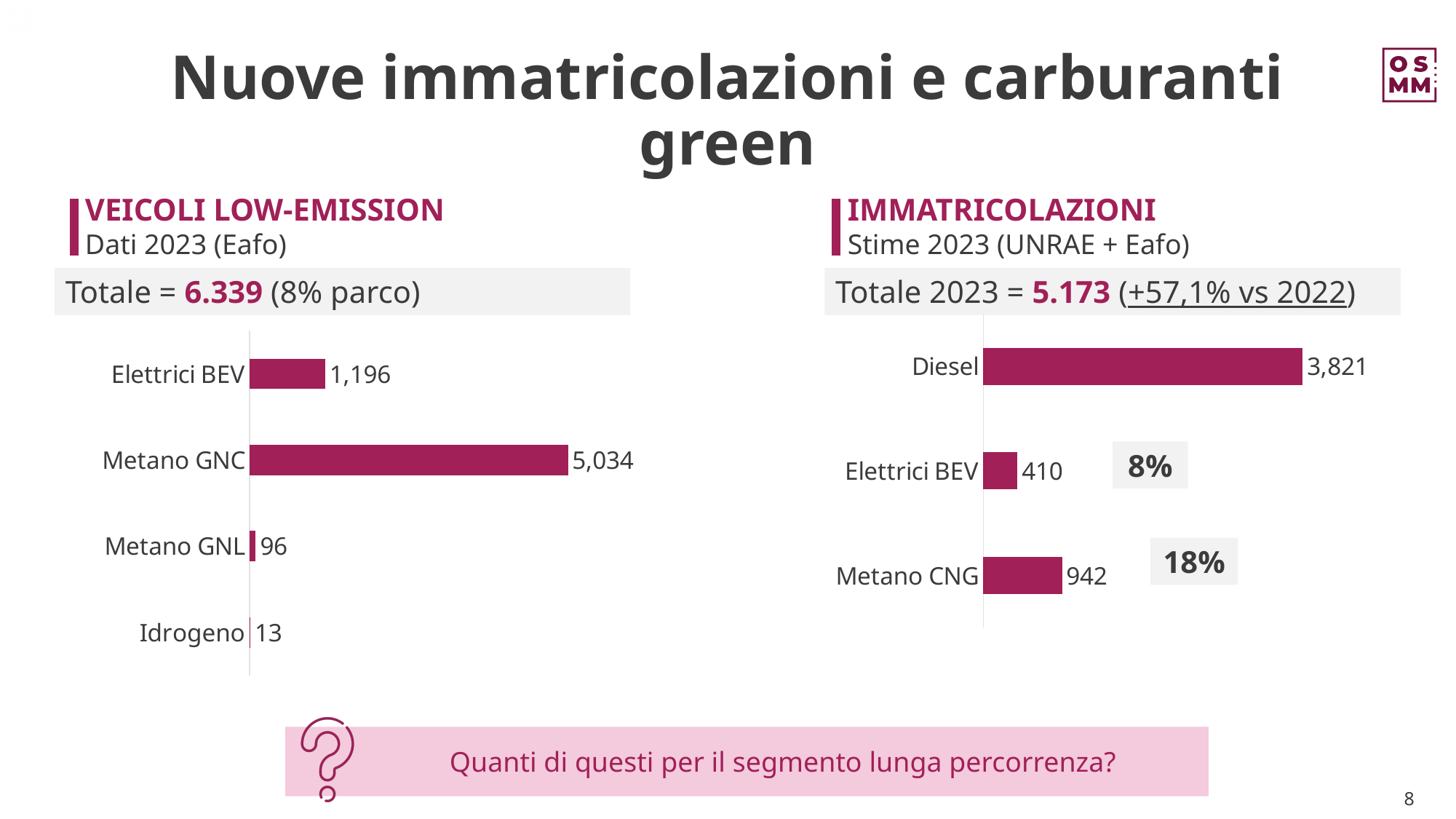
In the VEICOLI LOW-EMISSION chart on the left, which category has the lowest value? Idrogeno In the IMMATRICOLAZIONI chart on the right, what is the value for Metano CNG? 942 What total is stated above the IMMATRICOLAZIONI chart on the right for 2023? 5.173 In the VEICOLI LOW-EMISSION chart on the left, what is the value for Idrogeno? 13 In the IMMATRICOLAZIONI chart on the right, what is the value for Diesel? 3,821 In the IMMATRICOLAZIONI chart on the right, which is larger, Elettrici BEV or Metano CNG? Metano CNG What kind of chart is the IMMATRICOLAZIONI chart on the right? Bar chart In the VEICOLI LOW-EMISSION chart on the left, which category has the highest value? Metano GNC In the VEICOLI LOW-EMISSION chart on the left, what is the difference between Elettrici BEV and Metano GNL? 1,100 In the VEICOLI LOW-EMISSION chart on the left, what is the value for Metano GNC? 5,034 How many categories are shown in the VEICOLI LOW-EMISSION chart on the left? 4 In the IMMATRICOLAZIONI chart on the right, what is the difference between Diesel and Metano CNG? 2,879